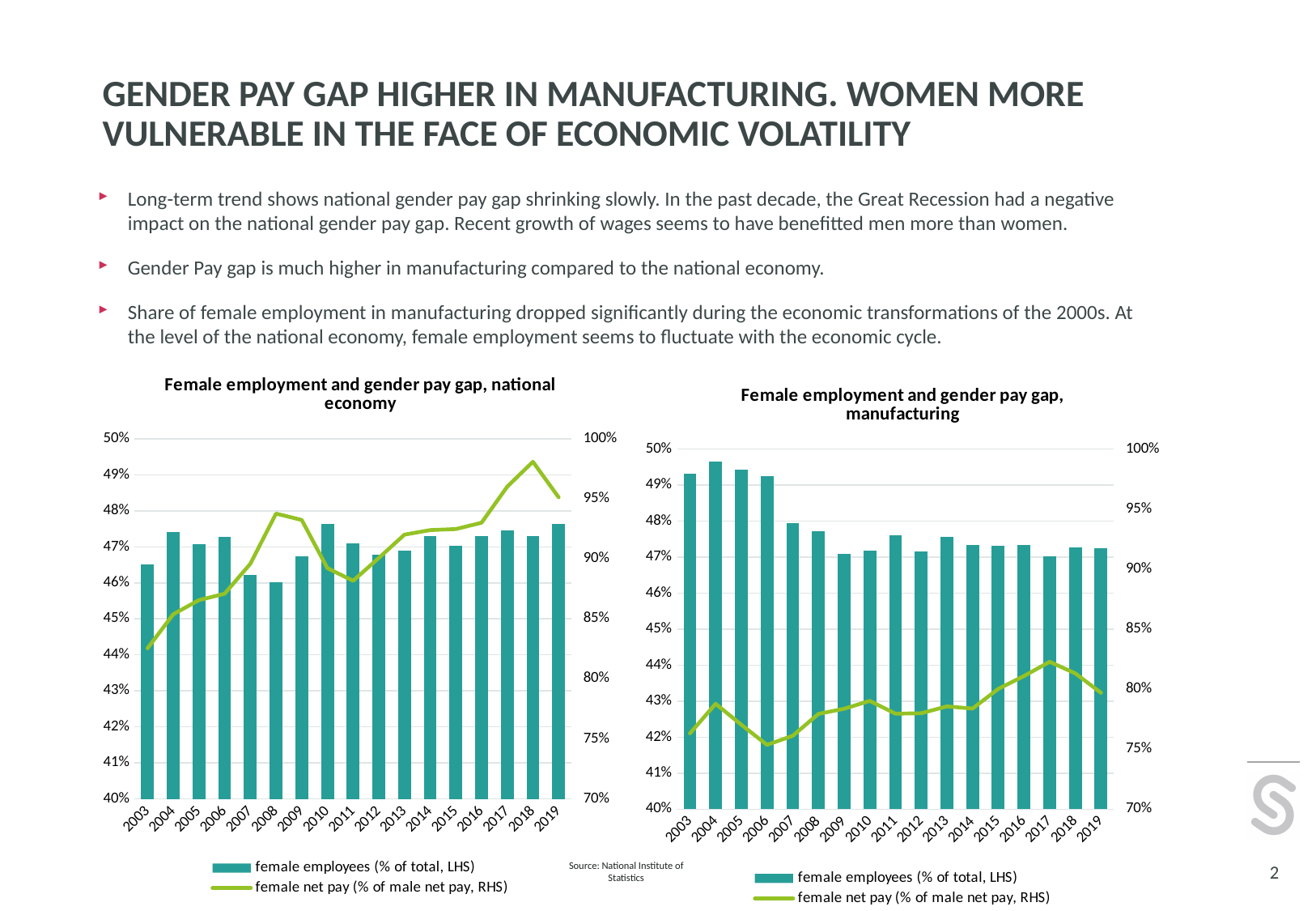
In the 'Female employment and gender pay gap, national economy' chart, which year has the lowest bar for female employees (% of total)? 2008 In the 'Female employment and gender pay gap, manufacturing' chart, which is larger: the female employees bar for 2003 or for 2019? 2003 In the 'Female employment and gender pay gap, manufacturing' chart, which year has the highest bar for female employees (% of total)? 2004 In the 'Female employment and gender pay gap, national economy' chart, is the female net pay value for 2003 greater or less than 85%? less How many series does the legend of the 'Female employment and gender pay gap, national economy' chart list? 2 In the 'Female employment and gender pay gap, national economy' chart, is the female employees bar for 2008 greater or less than 47%? less In the 'Female employment and gender pay gap, manufacturing' chart, do the female employees bars generally rise or fall from 2003 to 2019? fall In the 'Female employment and gender pay gap, manufacturing' chart, in which year is the female net pay line at its lowest point? 2006 In the 'Female employment and gender pay gap, national economy' chart, in which year does the female net pay line reach its highest point? 2018 What type of chart is the 'Female employment and gender pay gap, national economy' chart? Combined bar and line chart How many years are shown on the x axis of the 'Female employment and gender pay gap, manufacturing' chart? 17 In the 'Female employment and gender pay gap, manufacturing' chart, is the female net pay value for 2017 greater or less than 80%? greater